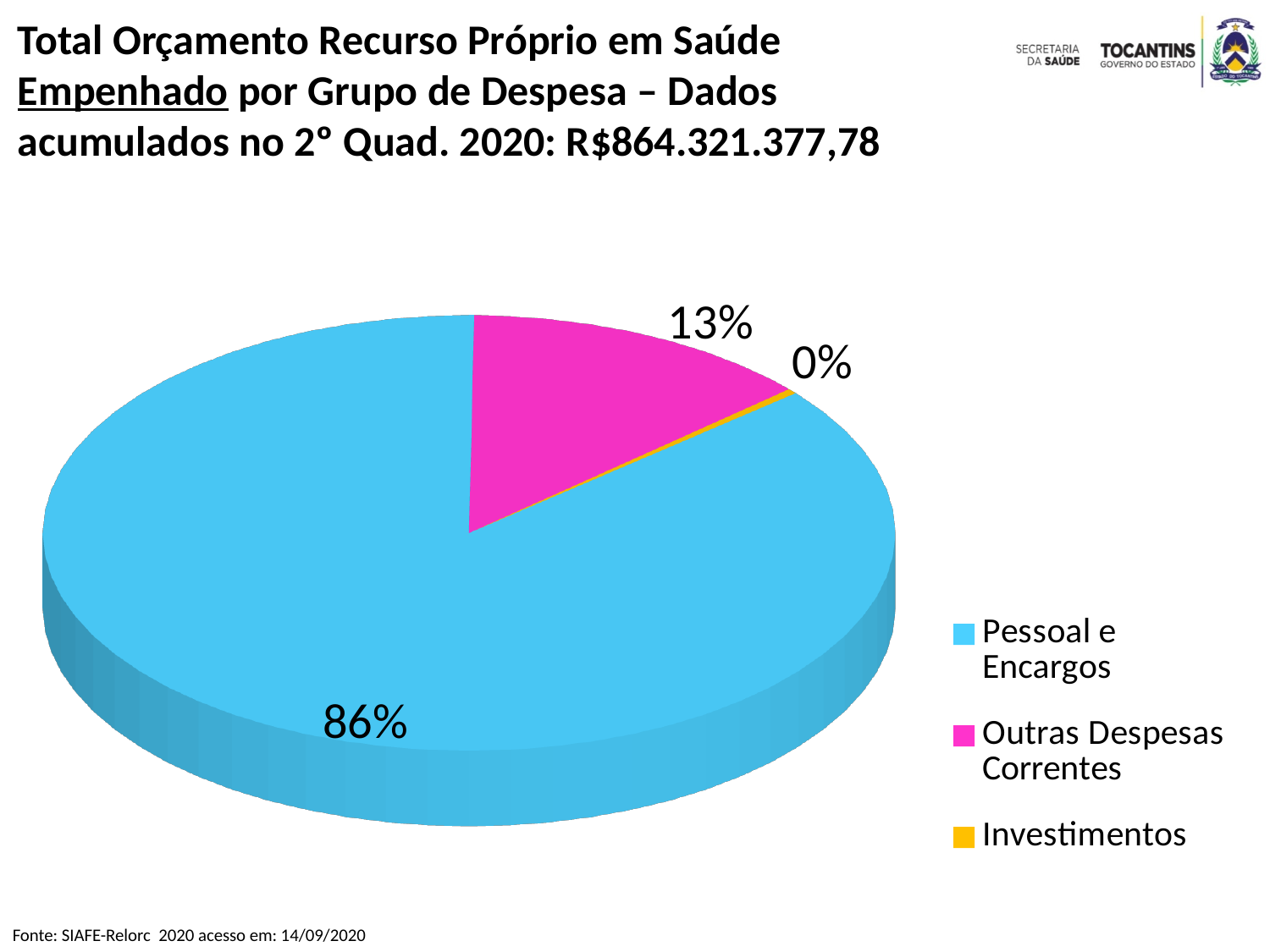
What is the difference in percentage points between Pessoal e Encargos and Outras Despesas Correntes? 73 Which is larger, the slice for Outras Despesas Correntes or the slice for Investimentos? Outras Despesas Correntes Which category has the smallest slice of the pie? Investimentos What share of the pie does Outras Despesas Correntes represent? 13% How many entries does the legend list? 3 What total value is stated in the slide title for the accumulated data in the 2nd quarter of 2020? R$864.321.377,78 Which category has the largest slice of the pie? Pessoal e Encargos What share of the pie does Pessoal e Encargos represent? 86% What share of the pie does Investimentos represent? 0% What kind of chart is shown on the slide? pie chart What colour is the slice for Outras Despesas Correntes? magenta (pink) How many categories does the pie chart show? 3